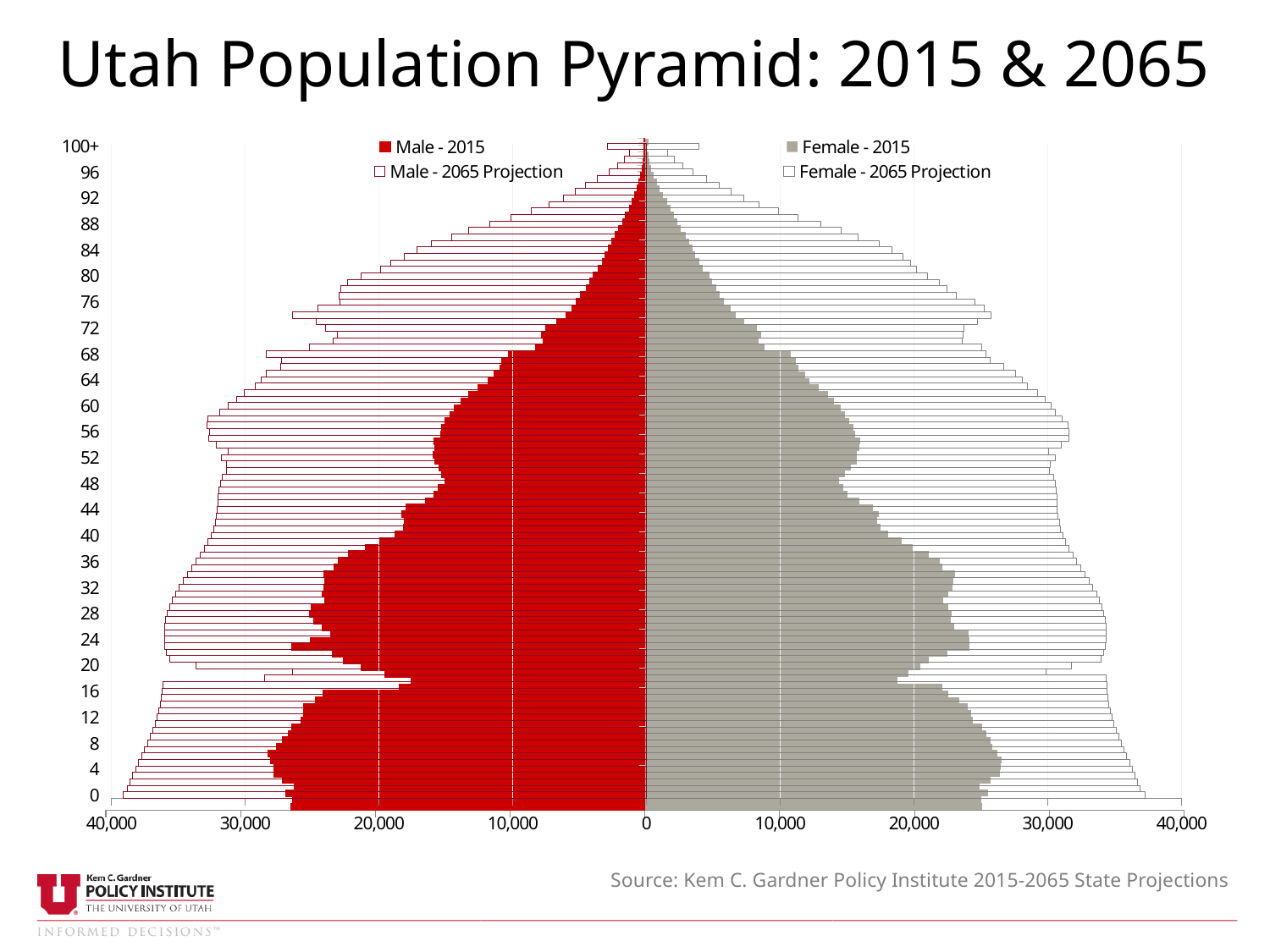
Is the Male - 2015 value at age 0 greater or less than 20,000? greater What is the title of the chart? Utah Population Pyramid: 2015 & 2065 What kind of chart is shown on the slide? Bar chart (population pyramid) Is the Female - 2065 Projection value at age 0 greater or less than 30,000? greater Is the Female - 2015 value at age 88 greater or less than 10,000? less For Male - 2015, do the values rise or fall as age increases from 60 to 100+? Fall How many series does the legend list? 4 At age 0, which is larger: the Male - 2015 value or the Male - 2065 Projection value? Male - 2065 Projection Which legend entry is shown as a solid red bar? Male - 2015 For Female - 2015, which is larger: the value at age 8 or the value at age 60? Age 8